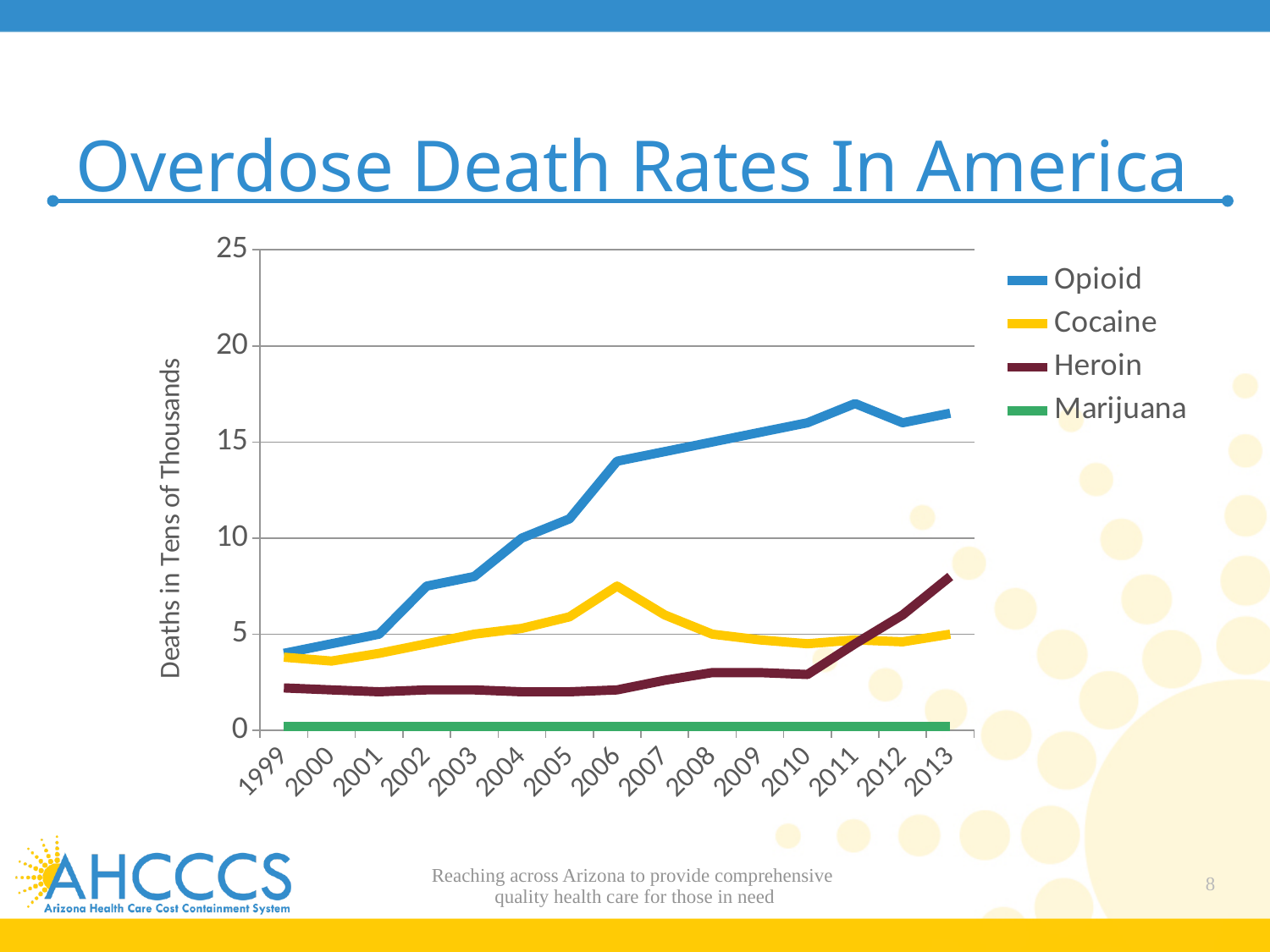
Is the Heroin value for 2013 greater or less than 5? greater How many series does the legend list? 4 Which series has the highest value in 2013? Opioid In 2013, which is larger, the Heroin value or the Cocaine value? Heroin Which series has the lowest values across all years? Marijuana Is the Opioid value for 2013 greater or less than 15? greater Is the Opioid value for 2006 greater or less than 10? greater In 2006, which is larger, the Cocaine value or the Heroin value? Cocaine How many years are shown along the x axis? 15 What is the label on the y axis? Deaths in Tens of Thousands Does the Opioid line generally rise or fall from 1999 to 2013? rise What kind of chart is shown on the slide? line chart